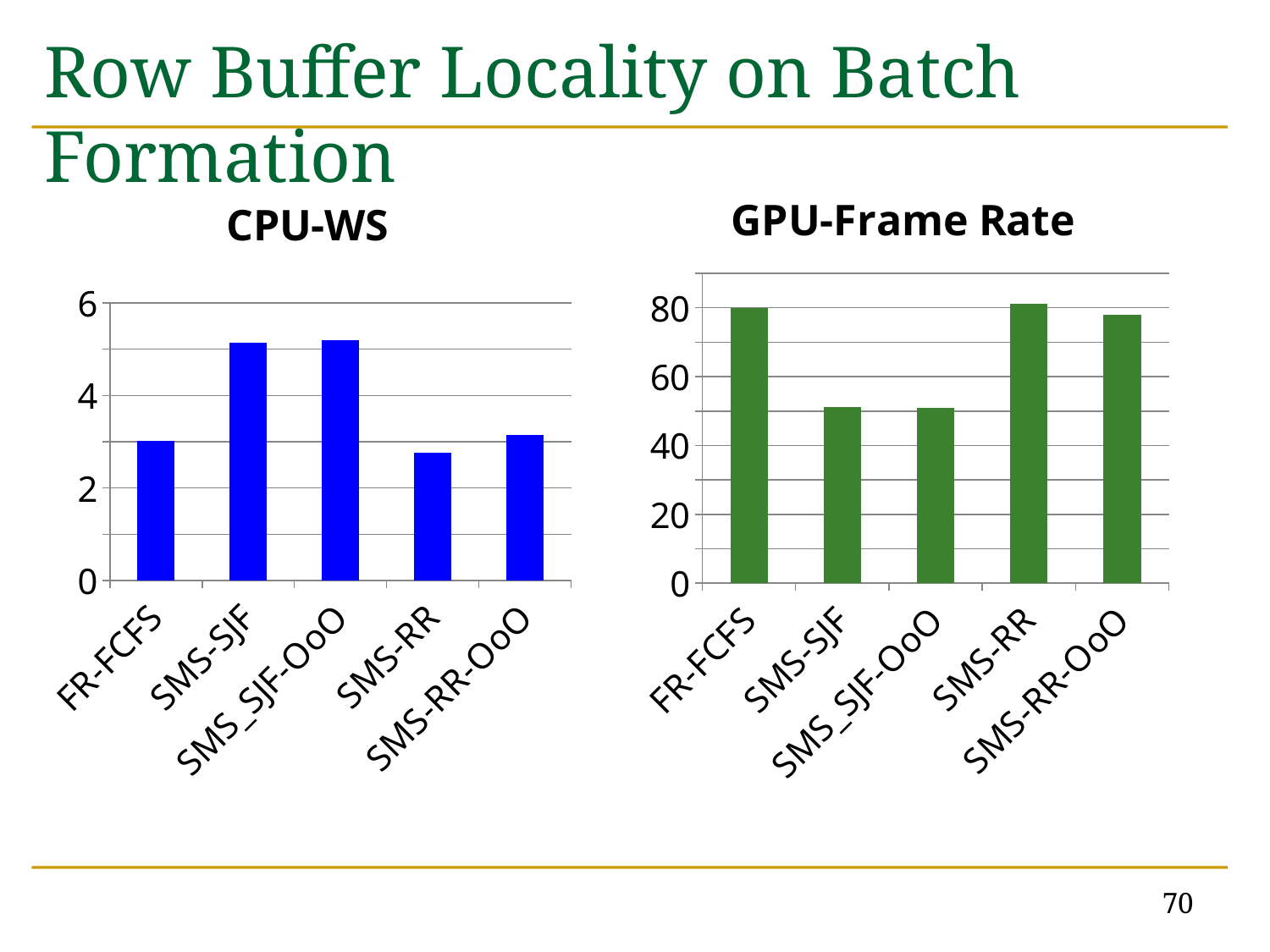
In the CPU-WS chart, is the value for SMS-RR greater or less than 4? less In the GPU-Frame Rate chart, is the value for SMS-SJF greater or less than 60? less In the GPU-Frame Rate chart, is the value for SMS-RR greater or less than 60? greater What kind of chart is the CPU-WS chart? bar chart What is the title of the chart on the left side of the slide? CPU-WS In the CPU-WS chart, which is larger, the value for SMS-SJF or the value for SMS-RR? SMS-SJF What colour are the bars in the GPU-Frame Rate chart? green How many categories are shown on the x axis of the GPU-Frame Rate chart? 5 How many bars does the CPU-WS chart have? 5 In the GPU-Frame Rate chart, which is larger, the value for FR-FCFS or the value for SMS_SJF-OoO? FR-FCFS